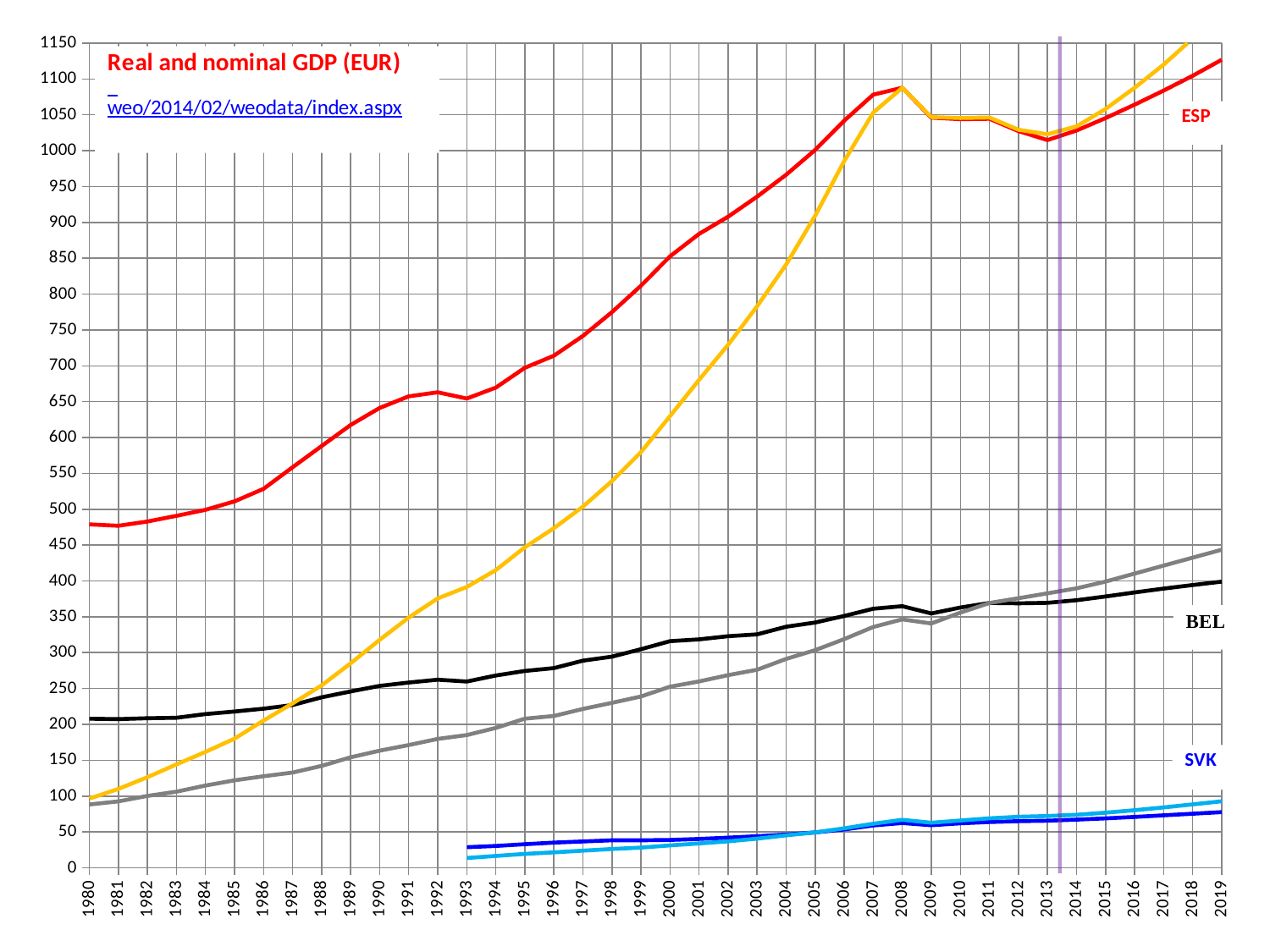
Does the red ESP line rise or fall between 1980 and 2007? rise In 2019, which is higher, the red ESP line or the black BEL line? ESP Is the value of the blue SVK line in 1993 greater or less than 50? less Is the value of the grey BEL line in 1980 greater or less than 100? less Which country's lines are the lowest on the chart? SVK How many years are shown on the x axis of the chart? 40 What kind of chart is shown on the slide? line chart What is the title of the chart? Real and nominal GDP (EUR) How many countries are labelled on the chart? 3 Is the value of the red ESP line in 2008 greater or less than 1050? greater Which country's lines are the highest on the chart? ESP